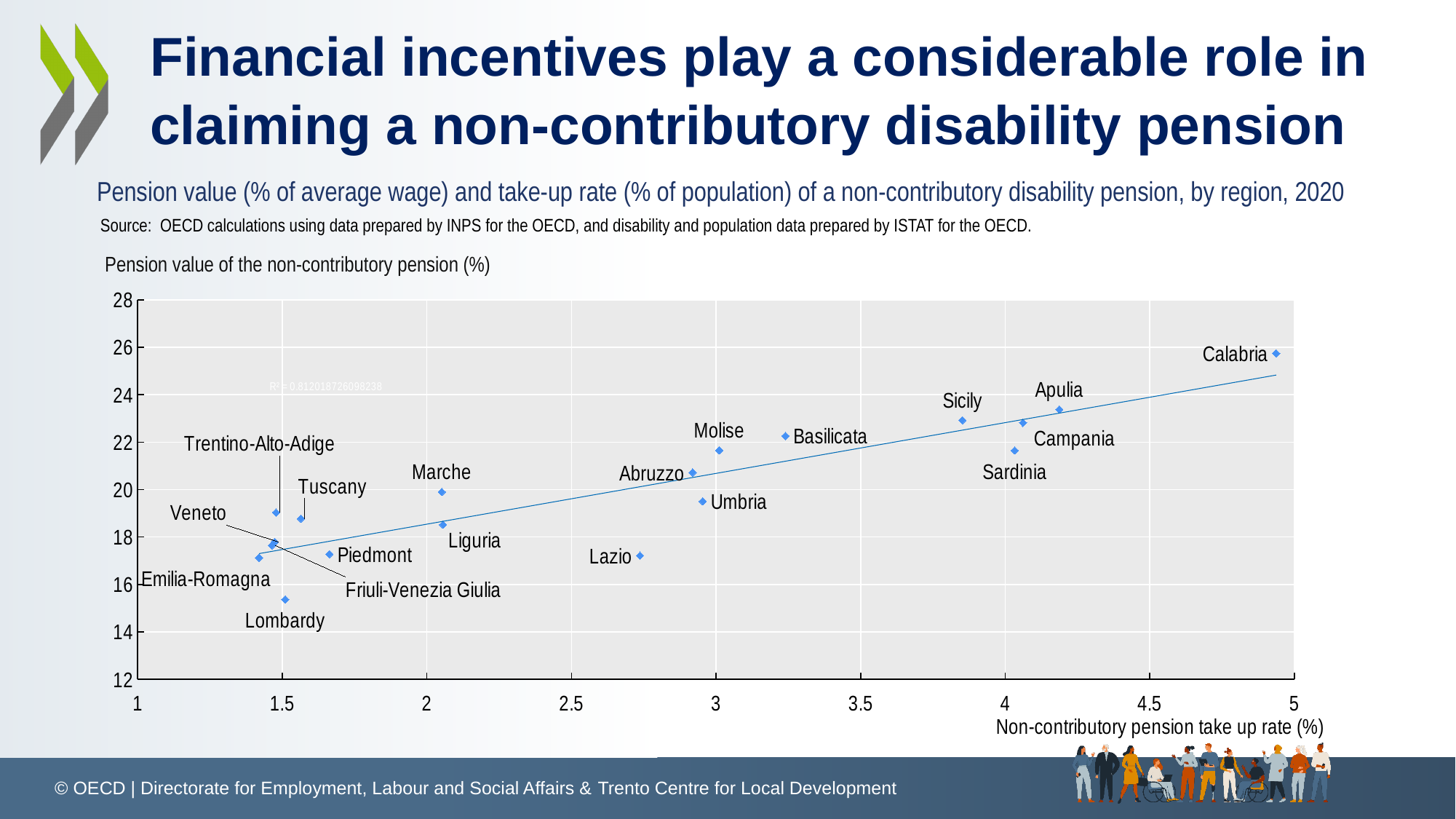
Which region has a higher pension value, Apulia or Sardinia? Apulia What is the label of the x axis? Non-contributory pension take up rate (%) How many regions are plotted on the chart? 19 Which region has the highest non-contributory pension take up rate? Calabria Is the non-contributory pension take up rate for Lazio greater or less than 2.5? greater What kind of chart is shown on the slide? Scatter chart Which region has the lowest pension value of the non-contributory pension? Lombardy Is the pension value for Calabria greater or less than 24? greater Which region has the highest pension value of the non-contributory pension? Calabria Is the pension value for Lombardy greater or less than 16? less Does the pension value generally rise or fall as the take up rate increases along the x axis? Rise Which region has a higher pension value, Marche or Liguria? Marche